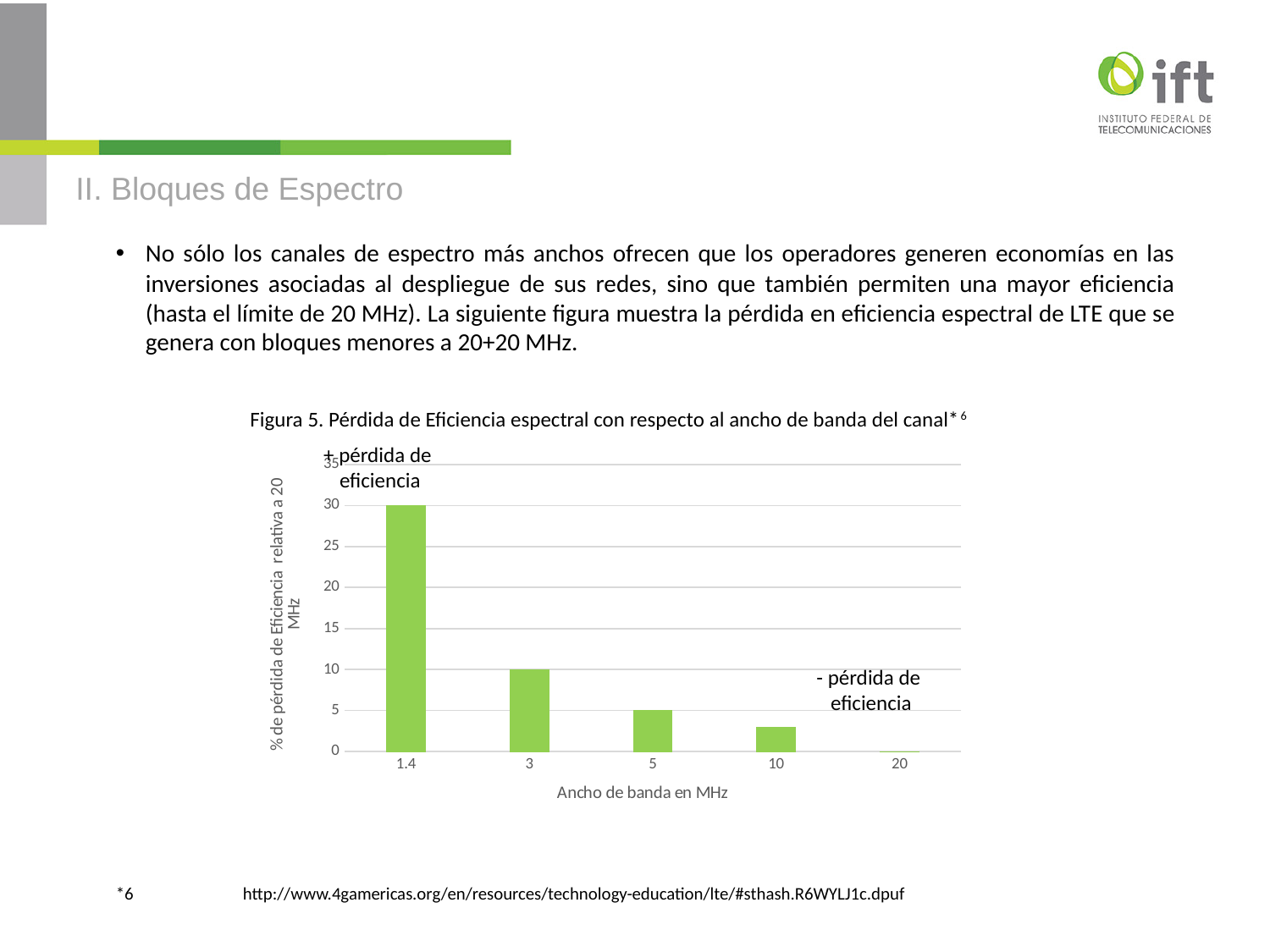
Which has a larger efficiency loss, the 3 MHz or the 10 MHz bandwidth? 3 What is the percentage of efficiency loss for the 5 MHz bandwidth? 5 Is the value for the 10 MHz bandwidth greater or less than 5? less Which bandwidth has the lowest percentage of spectral efficiency loss? 20 What is the difference in efficiency loss between the 1.4 MHz and 3 MHz bandwidths? 20 Do the values rise or fall as the bandwidth increases along the x axis? fall Which bandwidth has the highest percentage of spectral efficiency loss? 1.4 What is the percentage of efficiency loss for the 1.4 MHz bandwidth? 30 What kind of chart is shown on the slide? bar chart How many bandwidth categories are plotted on the x axis? 5 What is the title of the x axis? Ancho de banda en MHz What is the percentage of efficiency loss for the 3 MHz bandwidth? 10